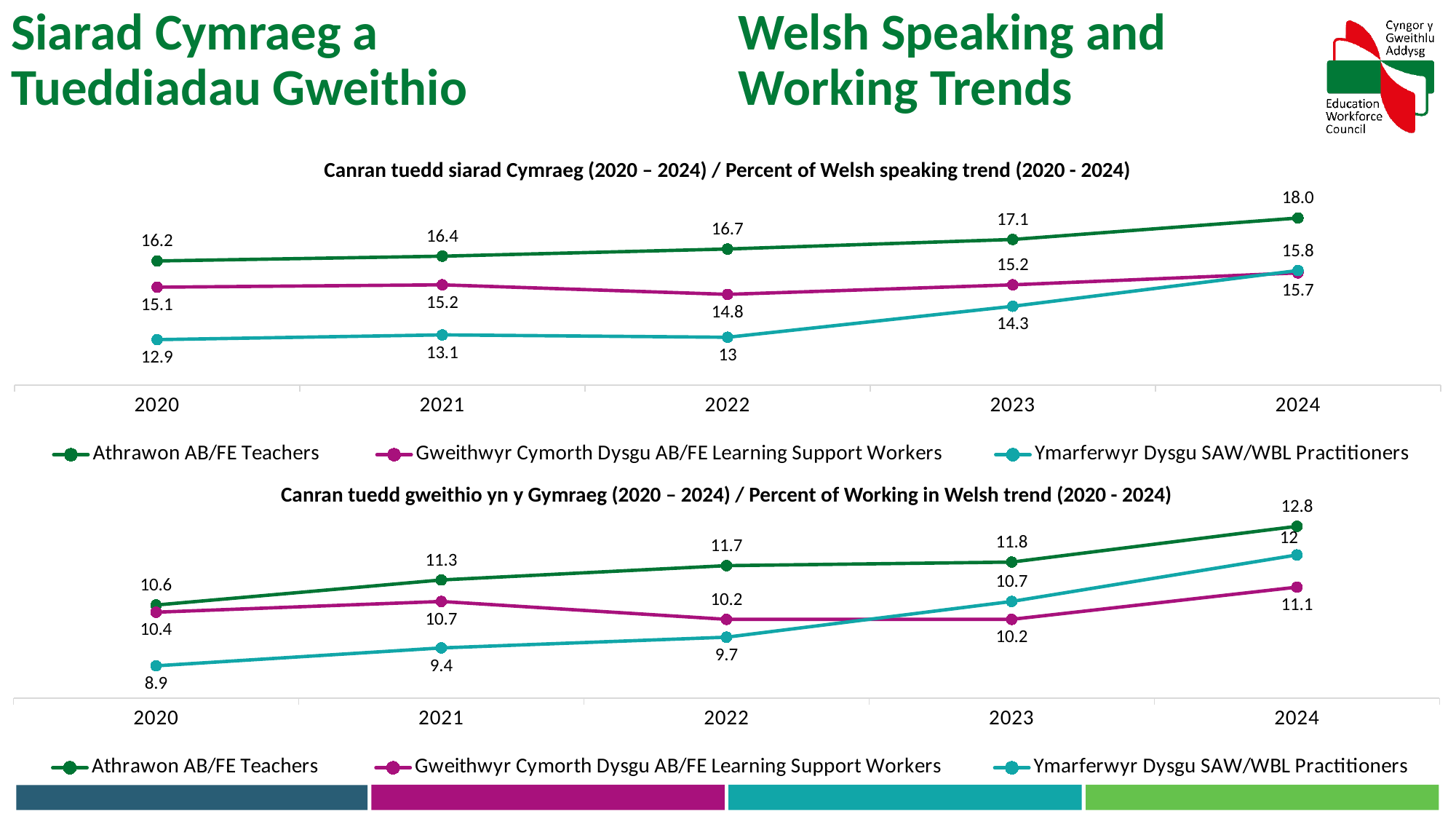
In the Percent of Working in Welsh trend chart, which is larger in 2024: AB/FE Teachers or SAW/WBL Practitioners? AB/FE Teachers In the Percent of Welsh speaking trend chart, what is the difference between the AB/FE Teachers value in 2024 and in 2020? 1.8 In the Percent of Working in Welsh trend chart, what is the value for SAW/WBL Practitioners in 2020? 8.9 What type of chart is the Percent of Welsh speaking trend chart? line chart In the Percent of Welsh speaking trend chart, what is the value for AB/FE Learning Support Workers in 2022? 14.8 How many series does the legend of the Percent of Working in Welsh trend chart list? 3 In the Percent of Welsh speaking trend chart, what is the value for SAW/WBL Practitioners in 2020? 12.9 In the Percent of Working in Welsh trend chart, which series has the lowest value in 2023? Gweithwyr Cymorth Dysgu AB/FE Learning Support Workers In the Percent of Welsh speaking trend chart, what is the value for AB/FE Teachers in 2024? 18.0 In the Percent of Welsh speaking trend chart, does the SAW/WBL Practitioners line generally rise or fall from 2020 to 2024? rise In the Percent of Welsh speaking trend chart, in which year is the AB/FE Teachers value highest? 2024 In the Percent of Working in Welsh trend chart, what is the value for AB/FE Learning Support Workers in 2024? 11.1